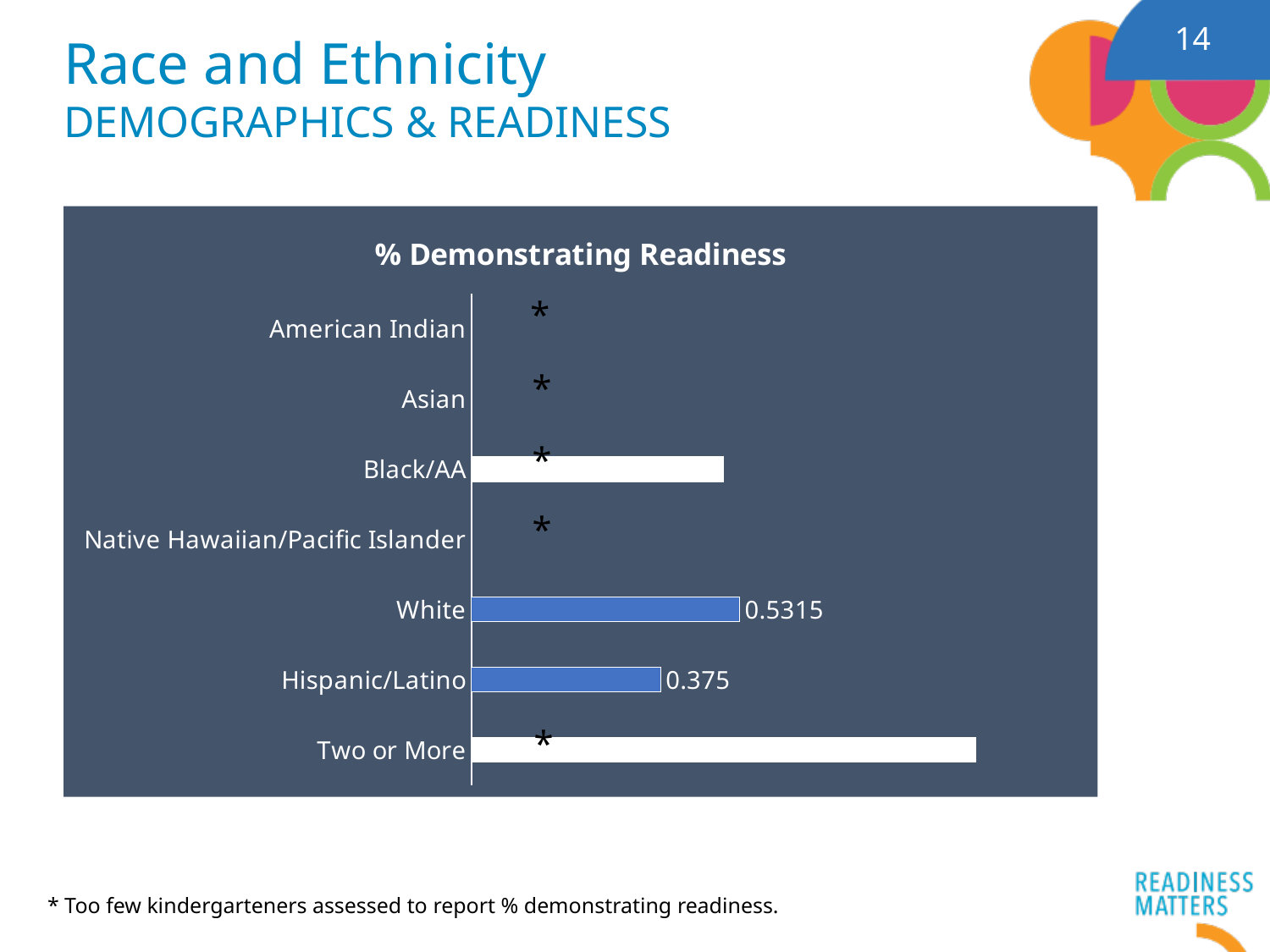
How many categories on the chart are marked with an asterisk instead of a reported value? 5 What is the value for Hispanic/Latino in the % Demonstrating Readiness chart? 0.375 Which two categories have a numeric value printed on the chart? White and Hispanic/Latino How many race/ethnicity categories are listed on the chart's axis? 7 According to the footnote, what does the asterisk on the chart indicate? Too few kindergarteners assessed to report % demonstrating readiness What is the title of the chart? % Demonstrating Readiness What is the difference between the values for White and Hispanic/Latino? 0.1565 What kind of chart is shown on the slide? Bar chart Which has a larger value, White or Hispanic/Latino? White What is the value for White in the % Demonstrating Readiness chart? 0.5315